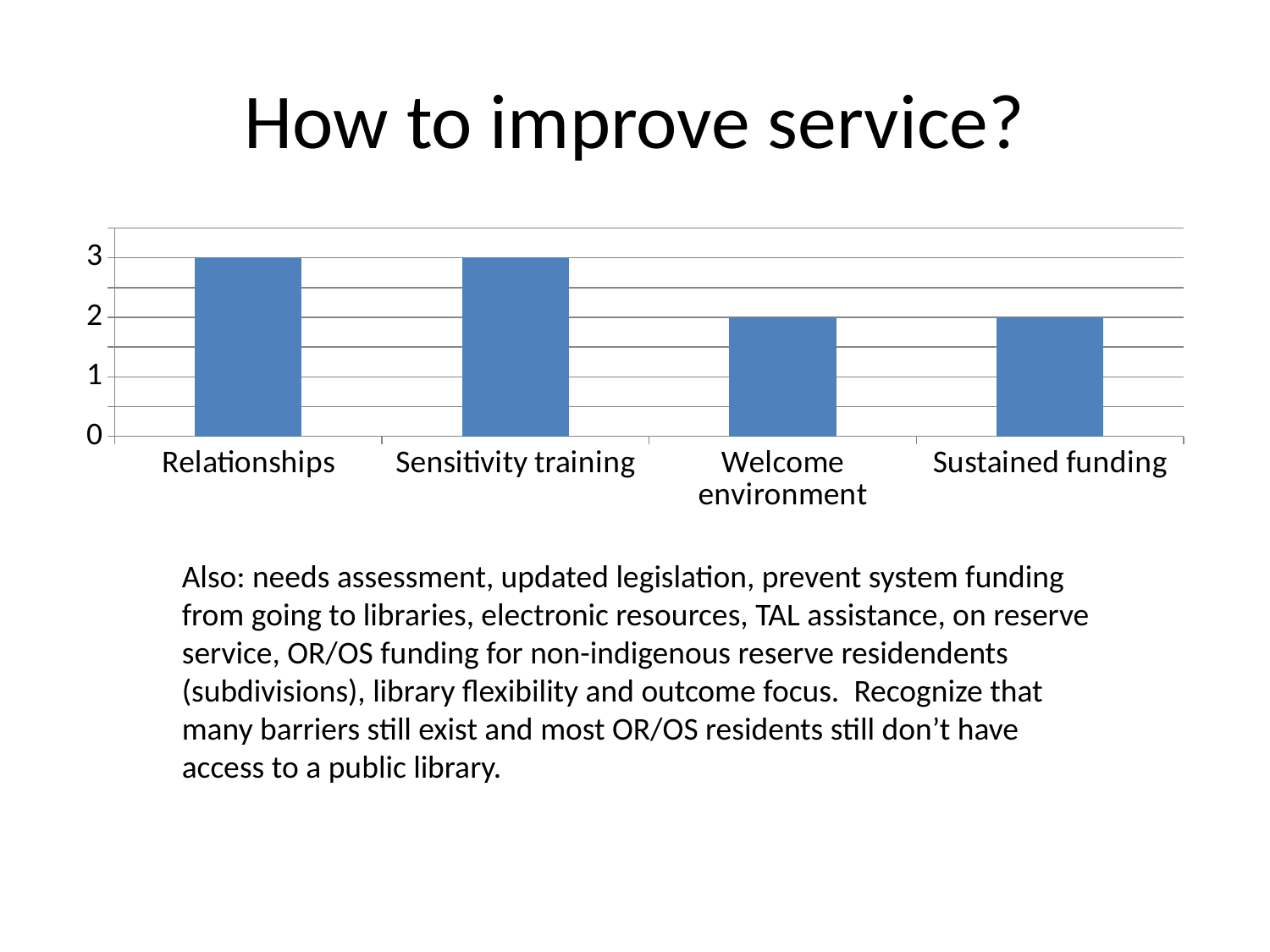
What is the difference between the value for Relationships and the value for Welcome environment? 1 How many categories are shown on the chart? 4 Which is larger, the value for Sustained funding or the value for Sensitivity training? Sensitivity training What is the value for Relationships? 3 What is the value for Sensitivity training? 3 Do the values rise or fall from left to right along the x axis? Fall What kind of chart is shown on the slide? Bar chart Which is larger, the value for Relationships or the value for Welcome environment? Relationships What is the value for Sustained funding? 2 What is the difference between the value for Sensitivity training and the value for Sustained funding? 1 What is the value for Welcome environment? 2 What is the title of the slide containing the chart? How to improve service?